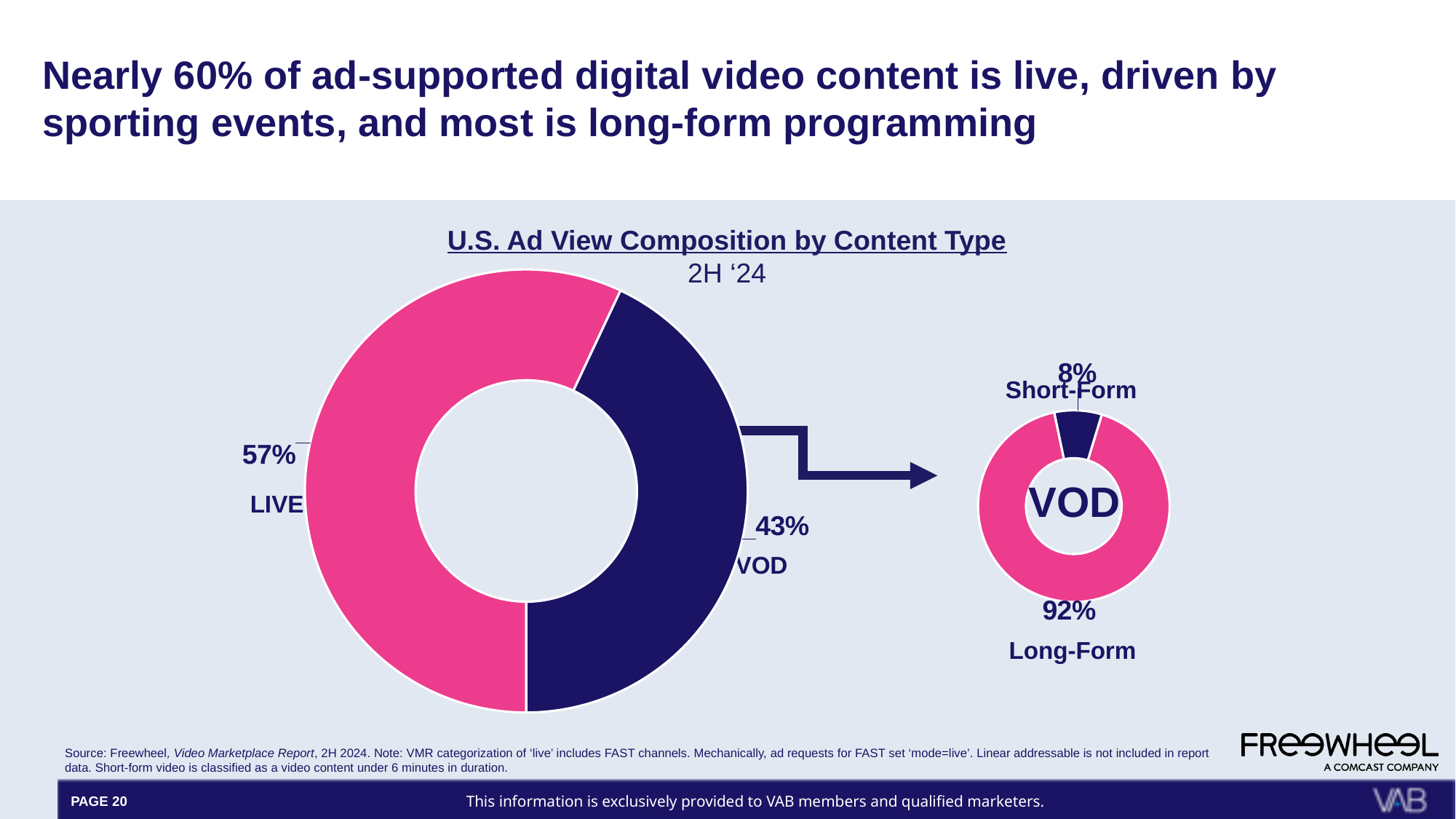
In the large 'U.S. Ad View Composition by Content Type' chart, which colour represents the LIVE segment? Pink In the large 'U.S. Ad View Composition by Content Type' chart, which content type has the larger share, LIVE or VOD? LIVE In the small VOD breakdown chart on the right, what share is Short-Form? 8% In the large 'U.S. Ad View Composition by Content Type' chart, what share of ad views is LIVE? 57% In the small VOD breakdown chart on the right, what is the difference in percentage points between Long-Form and Short-Form? 84 percentage points How many segments does the large 'U.S. Ad View Composition by Content Type' chart have? 2 What kind of chart is the large 'U.S. Ad View Composition by Content Type' chart? Doughnut (pie) chart In the large 'U.S. Ad View Composition by Content Type' chart, what share of ad views is VOD? 43% In the small VOD breakdown chart on the right, which segment is the smallest? Short-Form In the large 'U.S. Ad View Composition by Content Type' chart, what is the difference in percentage points between the LIVE and VOD shares? 14 percentage points In the small VOD breakdown chart on the right, what share is Long-Form? 92% What time period does the 'U.S. Ad View Composition by Content Type' chart cover? 2H '24